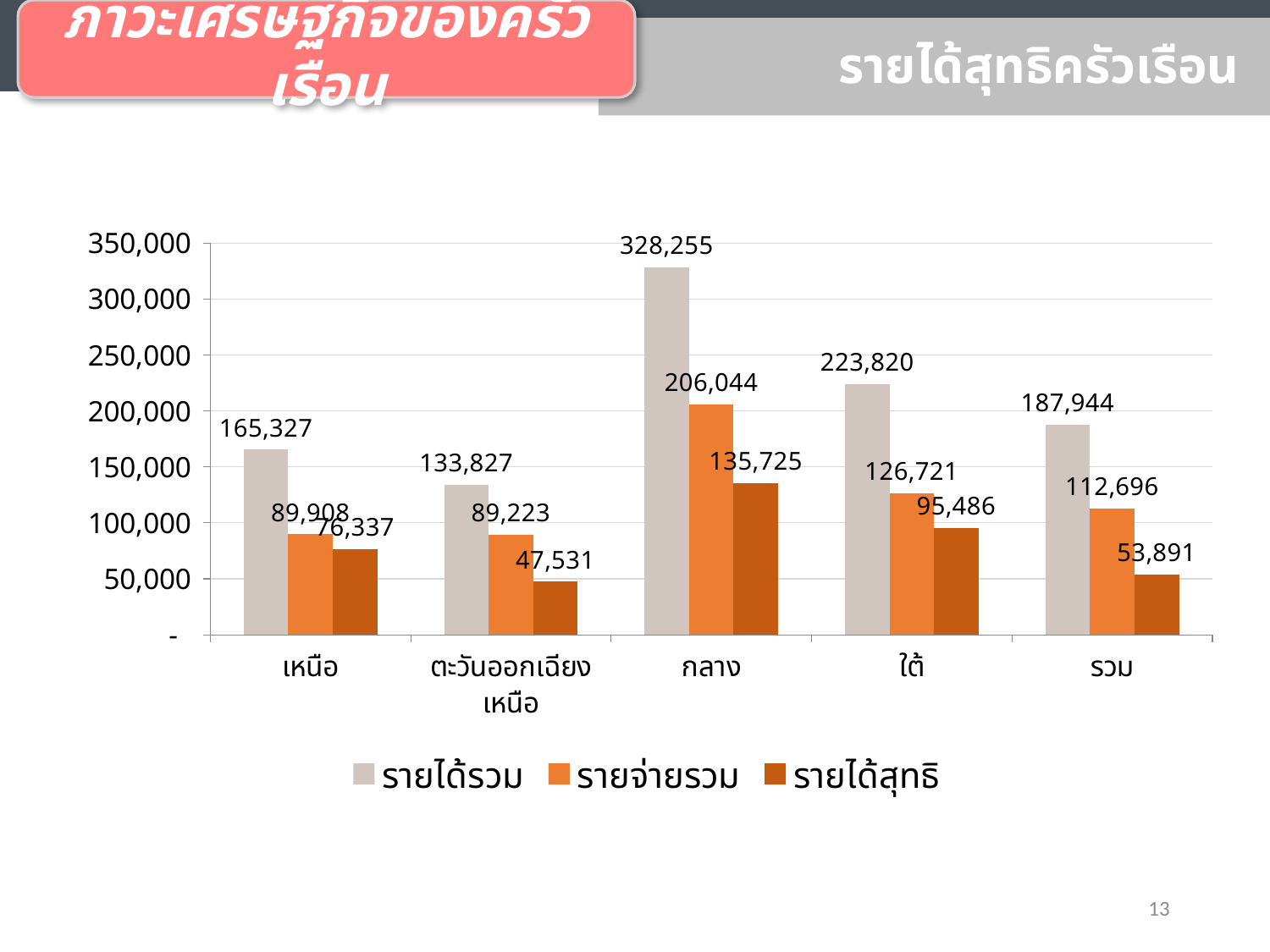
What is the value of รายจ่ายรวม for ใต้? 126,721 What is the value of รายได้สุทธิ for ตะวันออกเฉียงเหนือ? 47,531 How many series does the legend list? 3 Which category has the highest รายได้รวม? กลาง Is the value of รายจ่ายรวม for กลาง greater or less than 200,000? greater What is the value of รายได้รวม for กลาง? 328,255 What is the title shown in the grey header bar at the top right of the slide? รายได้สุทธิครัวเรือน How many categories are shown on the x axis? 5 Which category has the lowest รายได้สุทธิ? ตะวันออกเฉียงเหนือ What type of chart is shown on the slide? bar chart Which is larger, รายได้สุทธิ for เหนือ or รายได้สุทธิ for รวม? เหนือ What is the difference between รายได้รวม and รายจ่ายรวม for รวม? 75,248